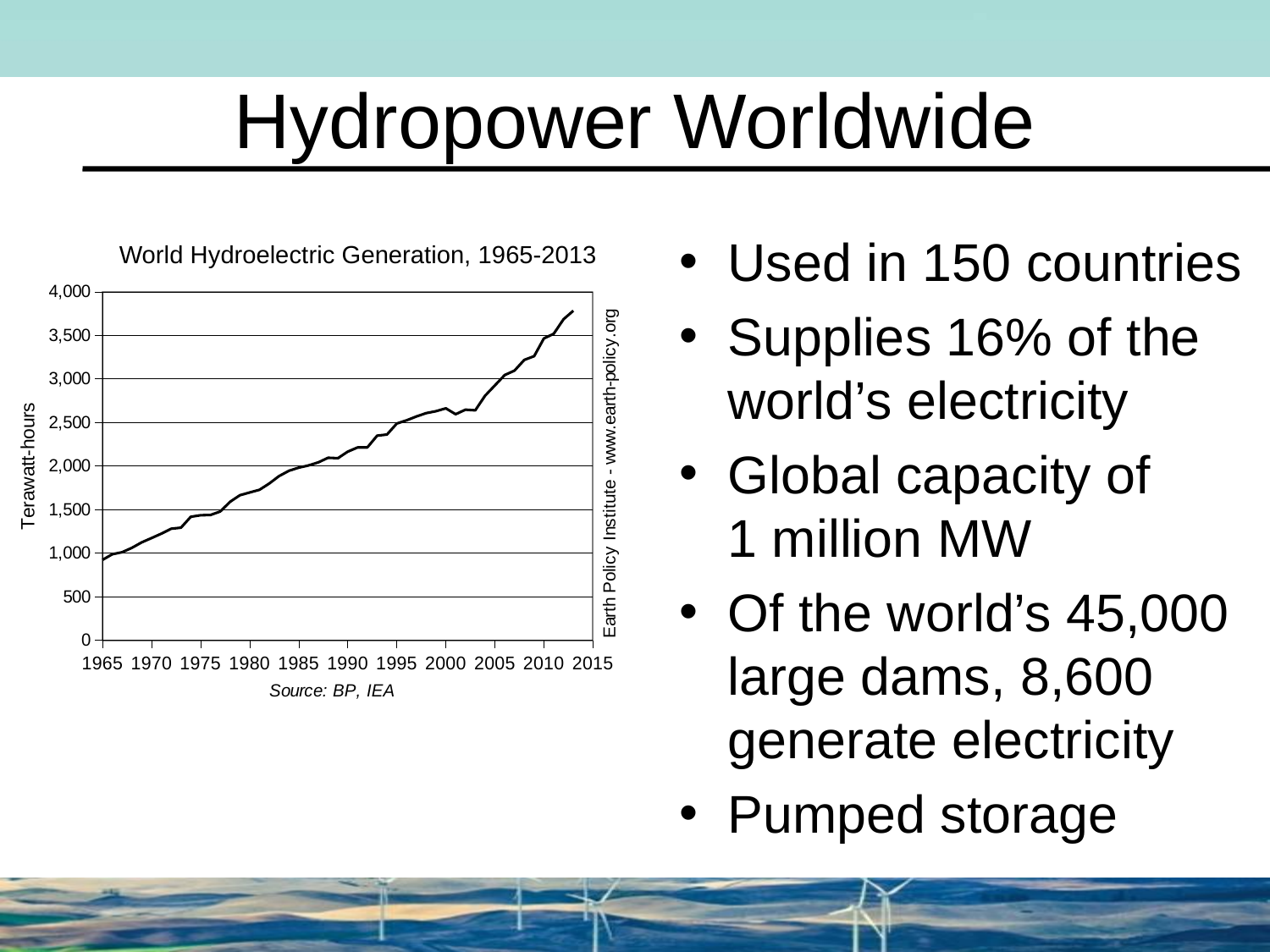
Is the value for 1975 greater or less than 1,000? greater Is the value for 2000 greater or less than 2,000? greater Is the value for 1965 greater or less than 1,500? less What kind of chart is shown on the slide? line chart In which year is the plotted value highest? 2013 Do the values in the chart generally rise or fall from 1965 to 2013? rise Which year has the larger value, 1990 or 2010? 2010 What unit is shown on the chart's vertical axis? Terawatt-hours What is the title of the chart? World Hydroelectric Generation, 1965-2013